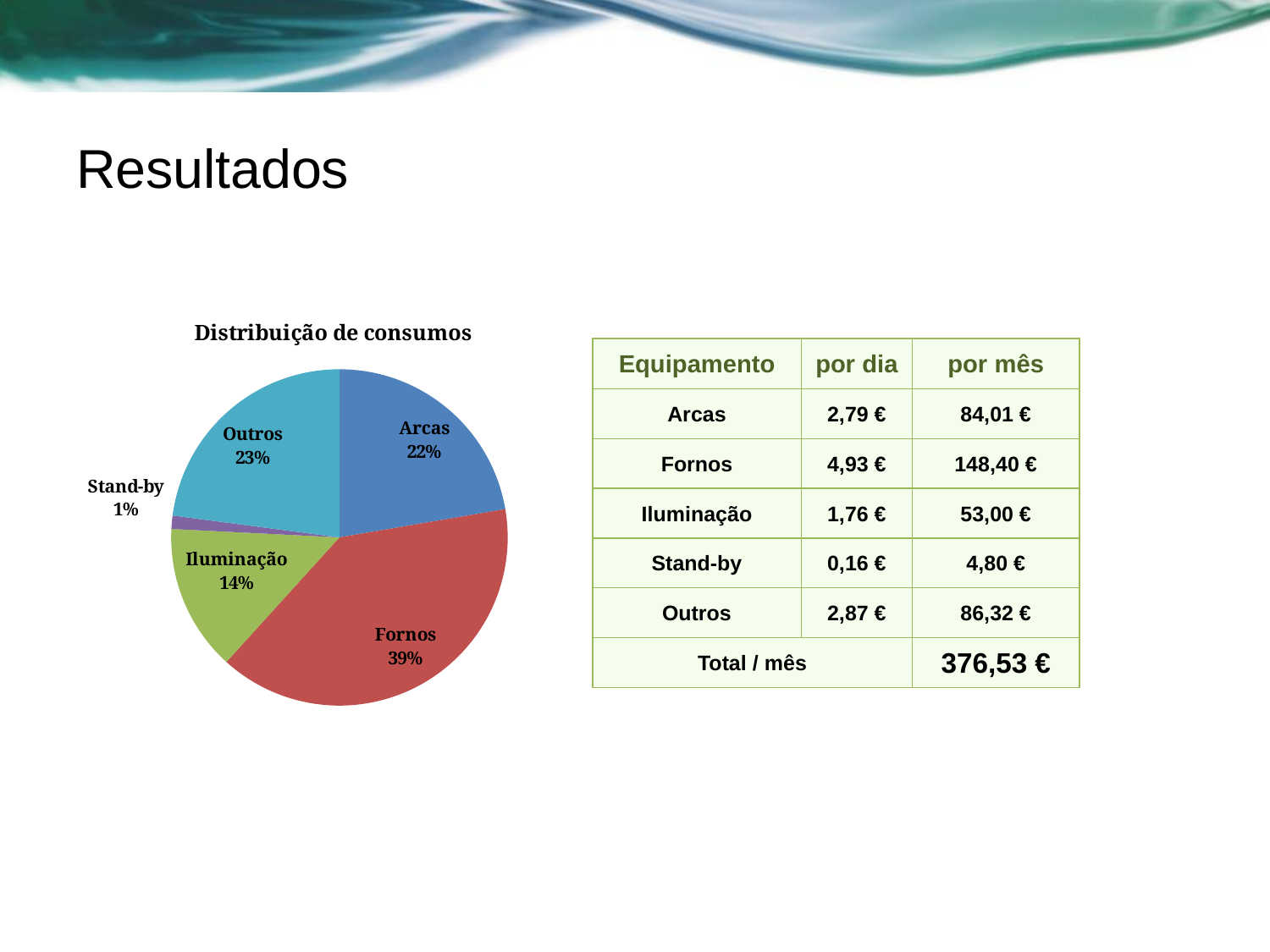
What share of the pie does Arcas represent? 22% What colour is the Fornos slice? red Which category has the smallest slice of the pie? Stand-by Which category has the largest slice of the pie? Fornos What kind of chart is shown on the slide? pie chart What is the difference in percentage points between the Fornos and Arcas slices? 17 How many slices does the pie chart have? 5 What share of the pie does Stand-by represent? 1% What share of the pie does Fornos represent? 39% What is the title of the chart? Distribuição de consumos Which slice is larger, Outros or Iluminação? Outros